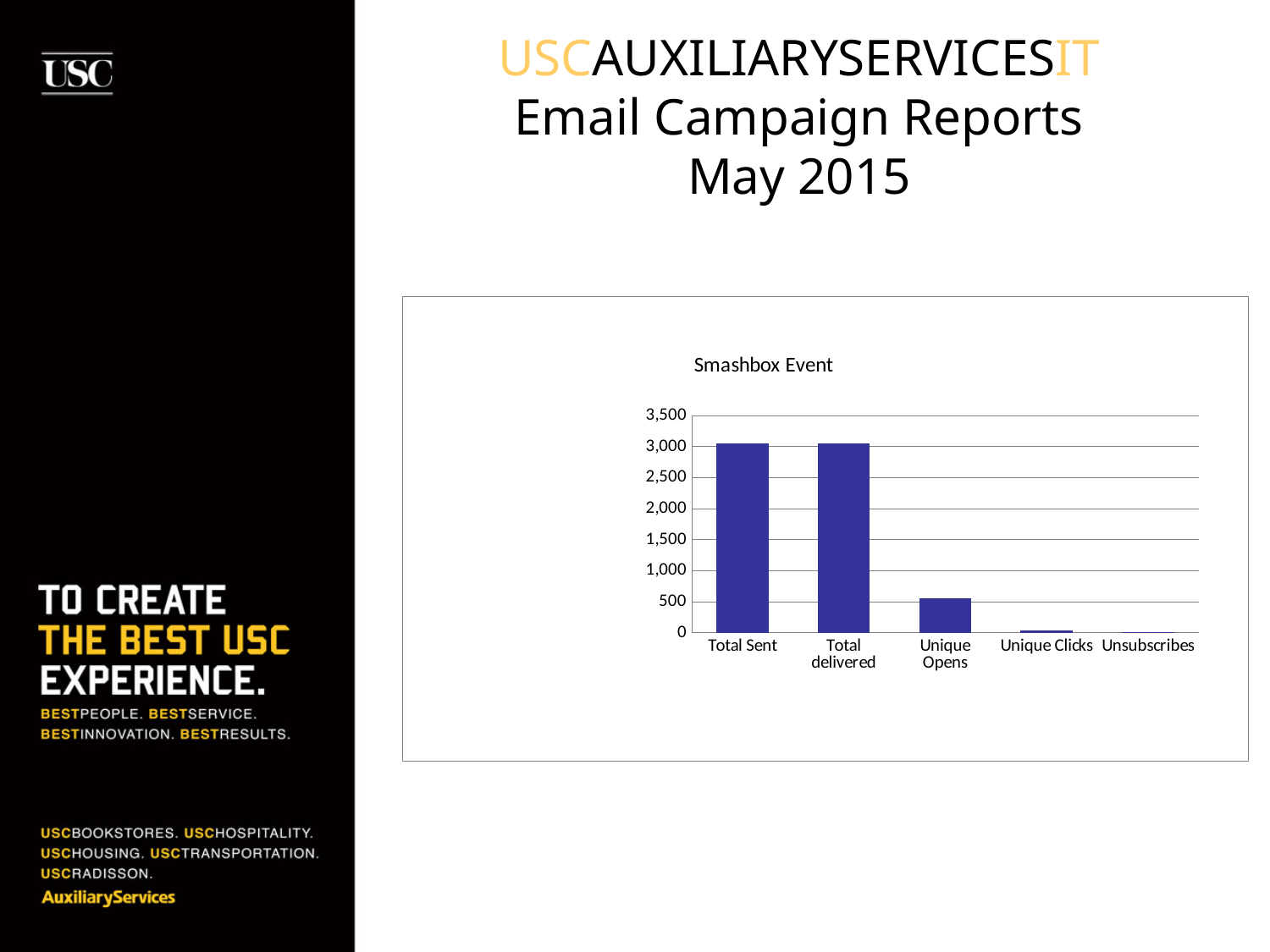
How many categories are shown on the x axis of the chart? 5 Is the value for Total delivered greater or less than 2,000? greater What is the title of the chart? Smashbox Event What is the highest value shown on the vertical axis of the chart? 3,500 What kind of chart is shown on the slide? bar chart Is the value for Unique Opens greater or less than 1,000? less Is the value for Total Sent greater or less than 2,500? greater Do the values generally rise or fall moving from left to right along the x axis? fall Which is larger, the value for Unique Opens or the value for Unique Clicks? Unique Opens Which category has the lowest value in the chart? Unsubscribes Which is larger, the value for Total Sent or the value for Unique Opens? Total Sent